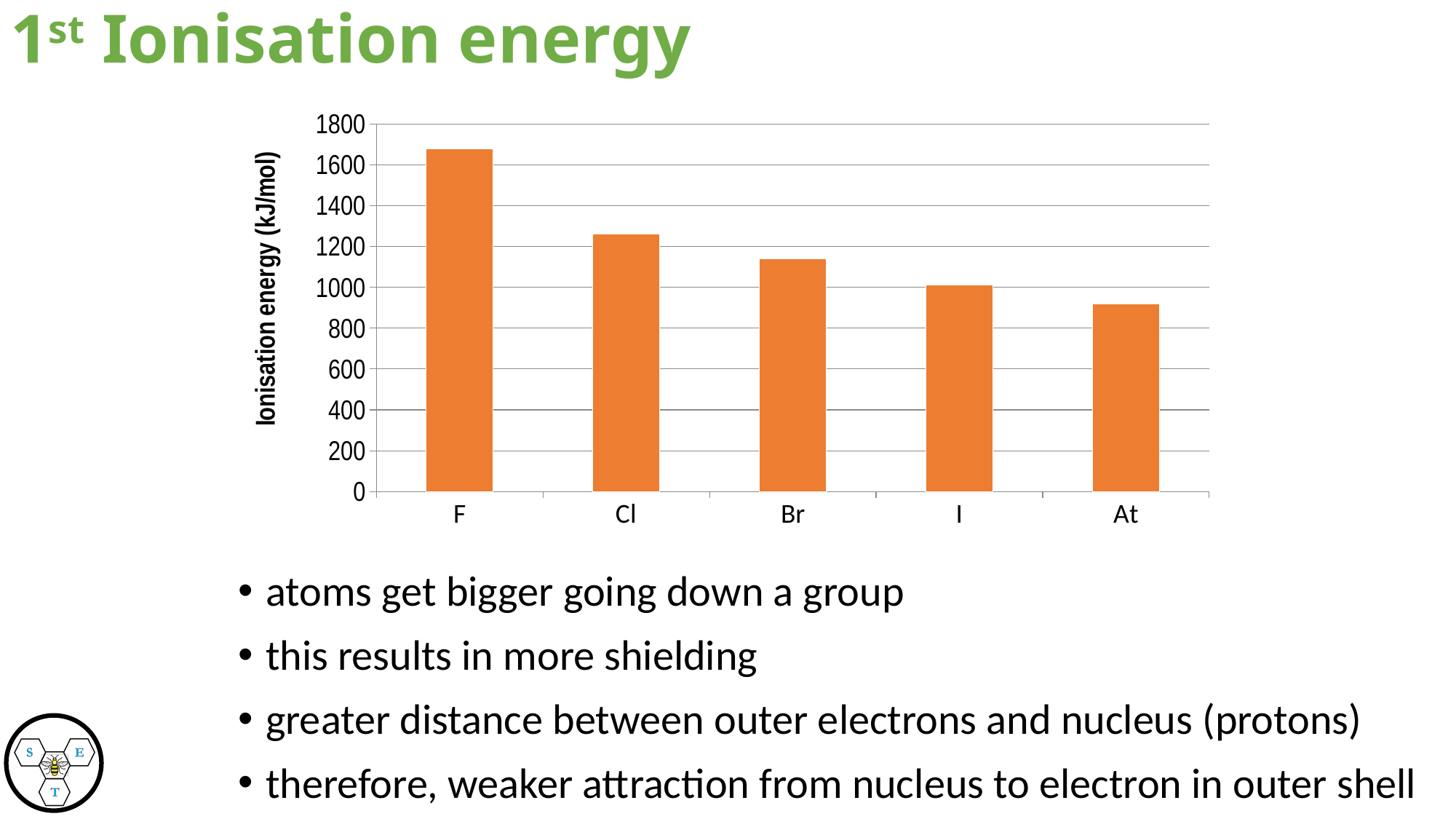
Which element has the lowest ionisation energy on the chart? At What type of chart is shown on the slide? bar chart Is the ionisation energy for At greater or less than 1000 kJ/mol? less How many elements are plotted on the chart? 5 Is the ionisation energy for F greater or less than 1600 kJ/mol? greater Which element has the highest ionisation energy on the chart? F Do the ionisation energy values rise or fall going from F to At along the x axis? fall Is the ionisation energy for I greater or less than 1200 kJ/mol? less What is the label on the vertical axis of the chart? Ionisation energy (kJ/mol) Which has the larger ionisation energy, Cl or I? Cl